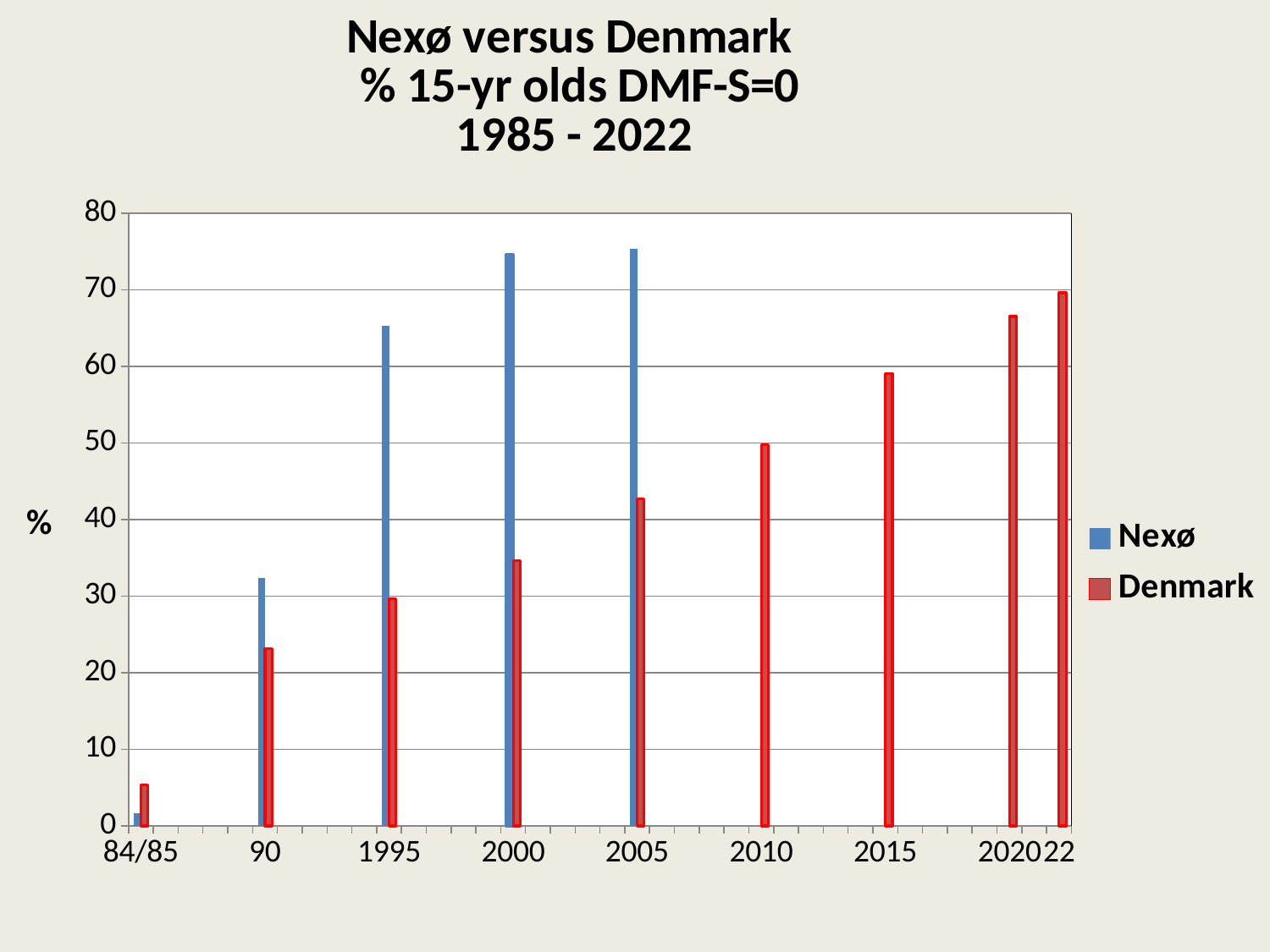
Is the Nexø value for 1995 greater or less than 60? greater How many series does the legend list? 2 What kind of chart is shown on the slide? bar chart In 1995, which series has the larger value, Nexø or Denmark? Nexø Is the Denmark value for 2000 greater or less than 40? less In which year is the Denmark value lowest? 84/85 How many year categories are shown on the x axis? 9 Is the Nexø value for 2000 greater or less than 70? greater Which colour represents the Denmark series? red In 84/85, which series has the larger value, Nexø or Denmark? Denmark Do the Denmark values rise or fall from 84/85 to 22? rise